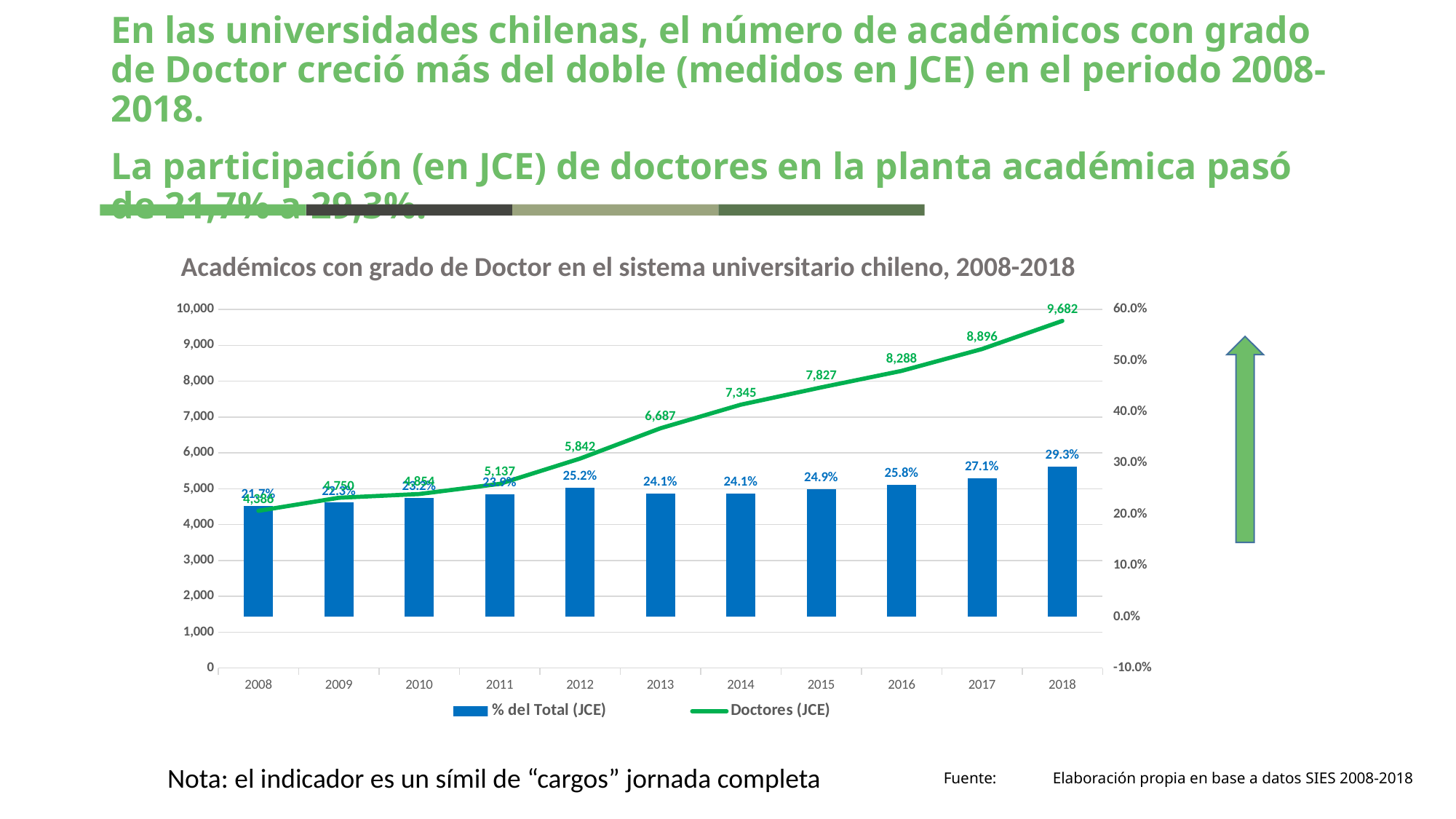
Which year has a larger value of Doctores (JCE), 2015 or 2016? 2016 What is the % del Total (JCE) shown for 2018? 29.3% What kind of chart is shown on the slide? Combined bar and line chart What is the value of Doctores (JCE) in 2013? 6,687 Does the Doctores (JCE) line rise or fall from 2008 to 2018? Rises Which year has the lowest % del Total (JCE)? 2008 What is the difference in Doctores (JCE) between 2018 and 2017? 786 What is the % del Total (JCE) shown for 2012? 25.2% How many years are shown on the x axis of the chart? 11 How many series does the chart legend list? 2 Which year has the highest value of Doctores (JCE)? 2018 What is the value of Doctores (JCE) in 2018? 9,682